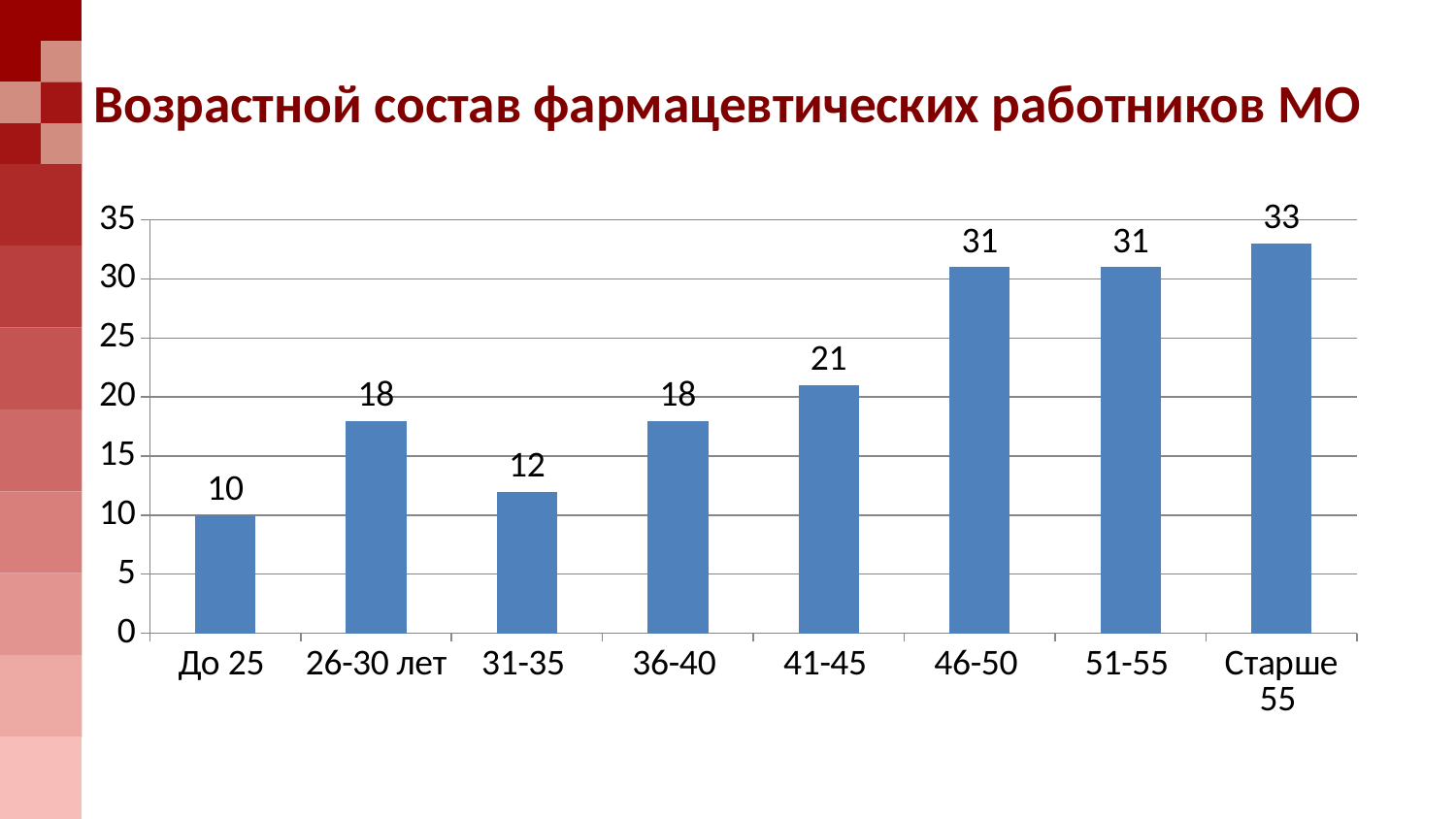
Which age group has the highest value? Старше 55 What is the title of the slide? Возрастной состав фармацевтических работников МО Do the values generally rise or fall from 'До 25' to 'Старше 55'? rise What is the value for the '41-45' age group? 21 What is the value for the 'Старше 55' age group? 33 What is the difference between the values for '46-50' and '31-35'? 19 What kind of chart is shown on the slide? bar chart Which age group has the lowest value? До 25 Which is larger, the value for '26-30 лет' or the value for '31-35'? 26-30 лет How many age groups are shown on the chart? 8 Is the value for '51-55' greater or less than 25? greater What is the value for the 'До 25' age group? 10